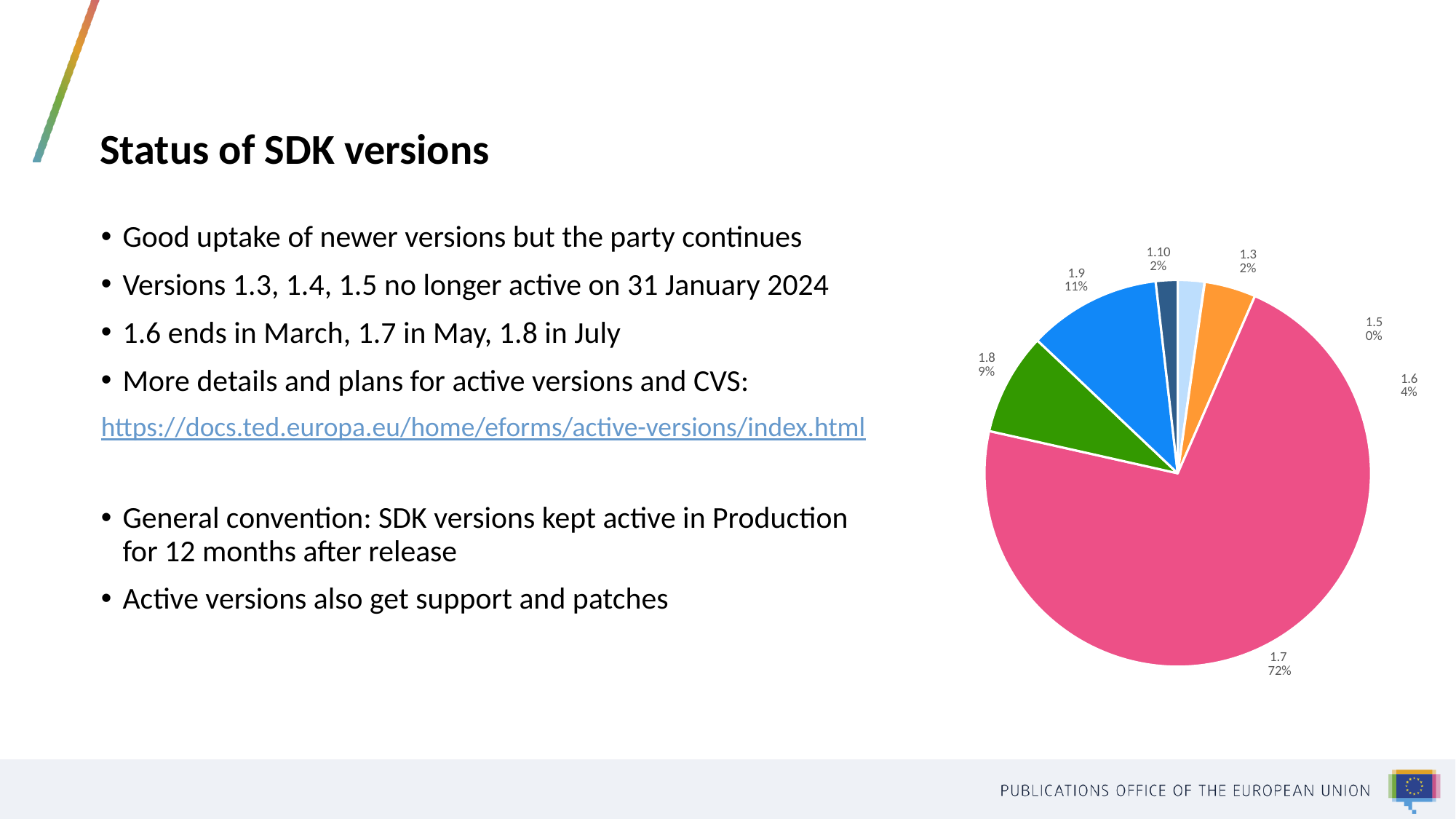
What kind of chart is shown on the slide? Pie chart What share of the pie does version 1.9 have? 11% Which version has the largest slice of the pie? 1.7 Which version has the smallest slice of the pie? 1.5 What share of the pie does version 1.7 have? 72% How many slices (versions) are shown in the pie chart? 7 What share of the pie does version 1.5 have? 0% What is the difference in percentage points between the shares of version 1.7 and version 1.9? 61 Which has a larger share, version 1.8 or version 1.9? 1.9 What colour is the slice for version 1.8? Green